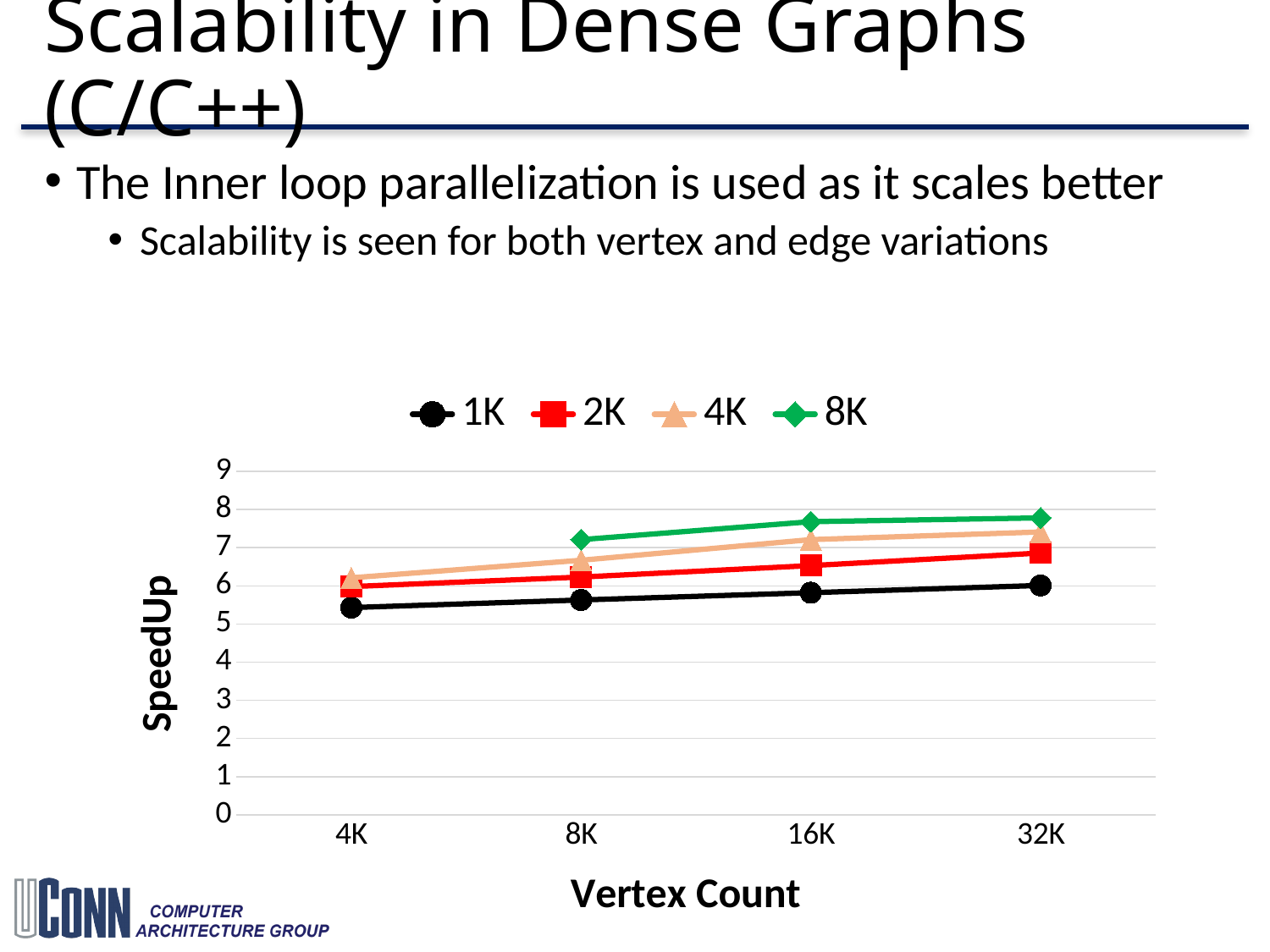
Which series has the highest SpeedUp at a vertex count of 32K? 8K Which series has the lowest SpeedUp at a vertex count of 32K? 1K How many series does the legend list? 4 Is the SpeedUp for the 2K series at a vertex count of 32K greater or less than 6? greater Is the SpeedUp for the 1K series at a vertex count of 4K greater or less than 6? less Does the SpeedUp for the 1K series rise or fall as the vertex count increases from 4K to 32K? rise At a vertex count of 16K, which series has the higher SpeedUp, 8K or 1K? 8K What is the title of the y axis? SpeedUp Is the SpeedUp for the 8K series at a vertex count of 32K greater or less than 7? greater What kind of chart is shown on the slide? line chart How many vertex count categories are shown on the x axis? 4